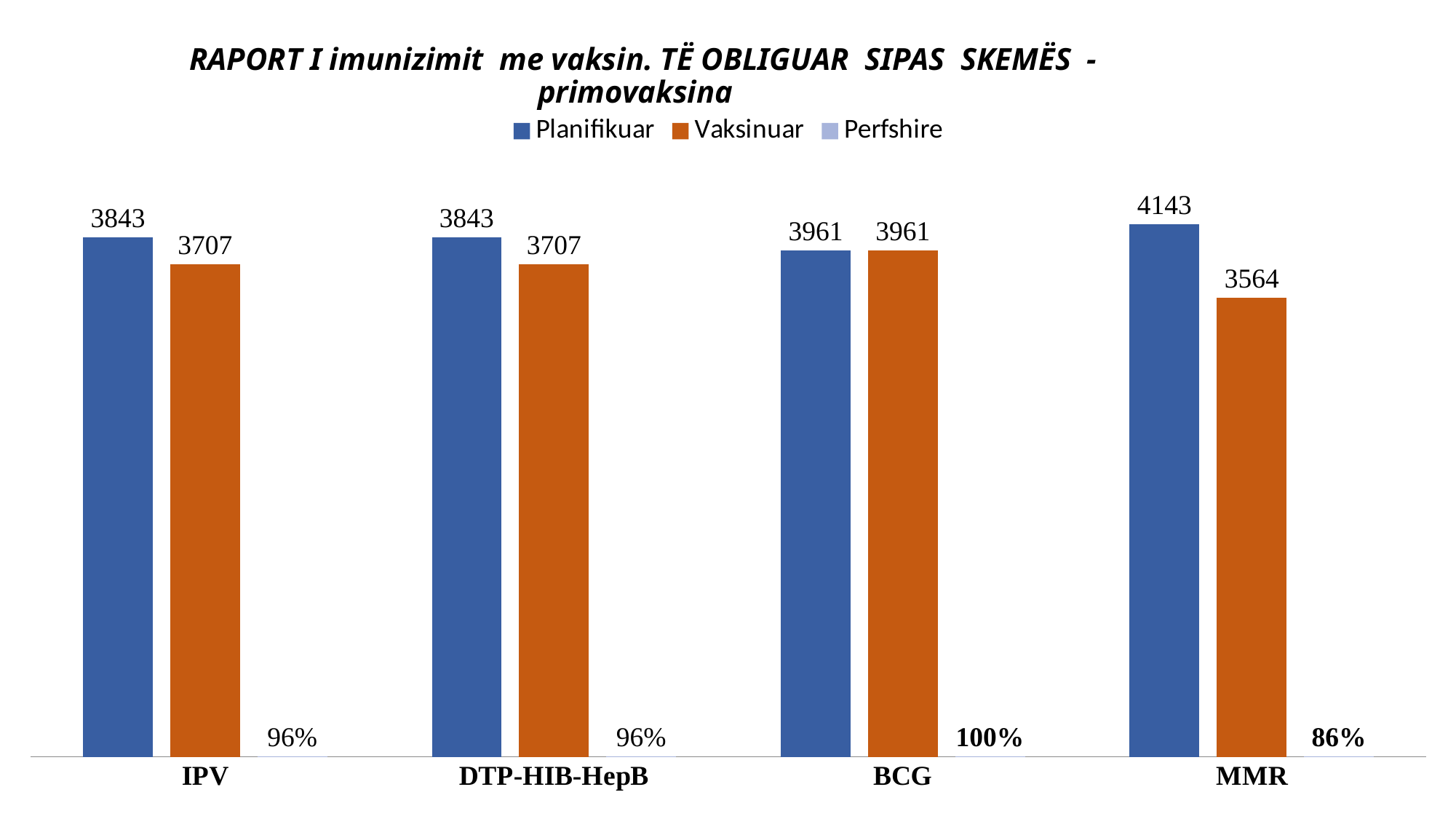
Which category has the highest Planifikuar value? MMR What is the difference between the Planifikuar and Vaksinuar values for MMR? 579 What is the Perfshire value shown for DTP-HIB-HepB? 96% What kind of chart is shown on the slide? Bar chart What is the Vaksinuar value for MMR? 3564 How many series does the legend list? 3 What is the Perfshire value shown for BCG? 100% What is the Planifikuar value for IPV? 3843 Which category has the lowest Vaksinuar value? MMR Which is larger for BCG, the Planifikuar value or the Vaksinuar value? They are equal (3961) How many categories are shown on the x axis? 4 What is the difference between the Planifikuar and Vaksinuar values for IPV? 136